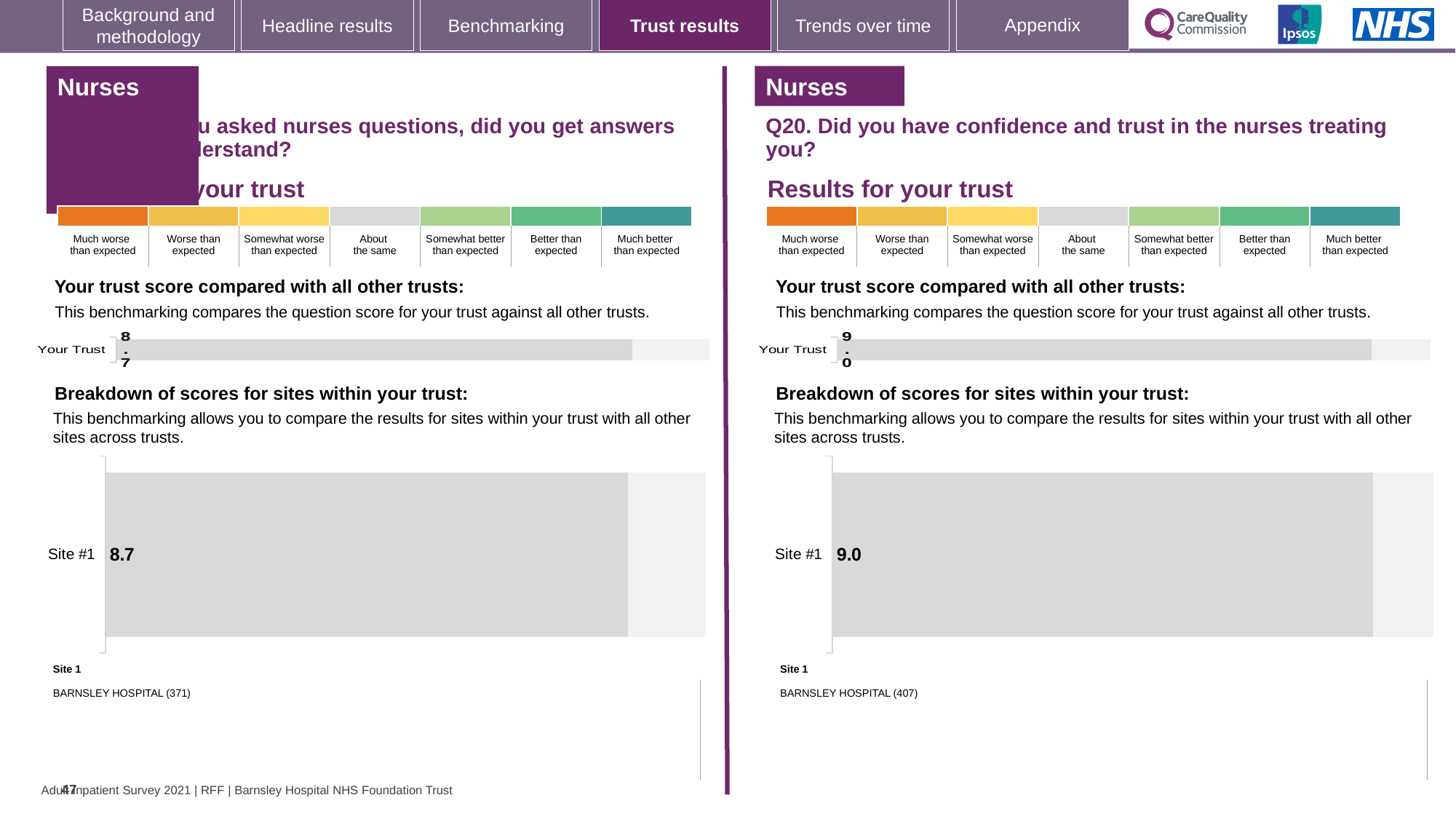
Which site is listed as Site 1 beneath the breakdown chart on the left-hand side of the slide? BARNSLEY HOSPITAL (371) Which site is listed as Site 1 beneath the breakdown chart on the right-hand side of the slide? BARNSLEY HOSPITAL (407) On the left-hand side of the slide, what is the score shown for Your Trust in the trust comparison chart? 8.7 In the breakdown of scores for sites chart on the left-hand side of the slide, what is the score for Site #1? 8.7 Which is larger: the Your Trust score on the left-hand chart or the Your Trust score on the right-hand Q20 chart? The right-hand Q20 chart (9.0) On the right-hand chart for Q20 (confidence and trust in nurses), what is the score shown for Your Trust? 9.0 What is the difference between the Site #1 score on the right-hand Q20 chart and the Site #1 score on the left-hand chart? 0.3 In the Q20 breakdown of scores for sites chart on the right, what is the score for Site #1? 9.0 How many sites are shown in the breakdown of scores for sites chart on the right-hand side of the slide? 1 What kind of chart is used for the Q20 breakdown of scores for sites on the right-hand side? Bar chart What kind of chart is used to show the Your Trust score on the left-hand side of the slide? Bar chart